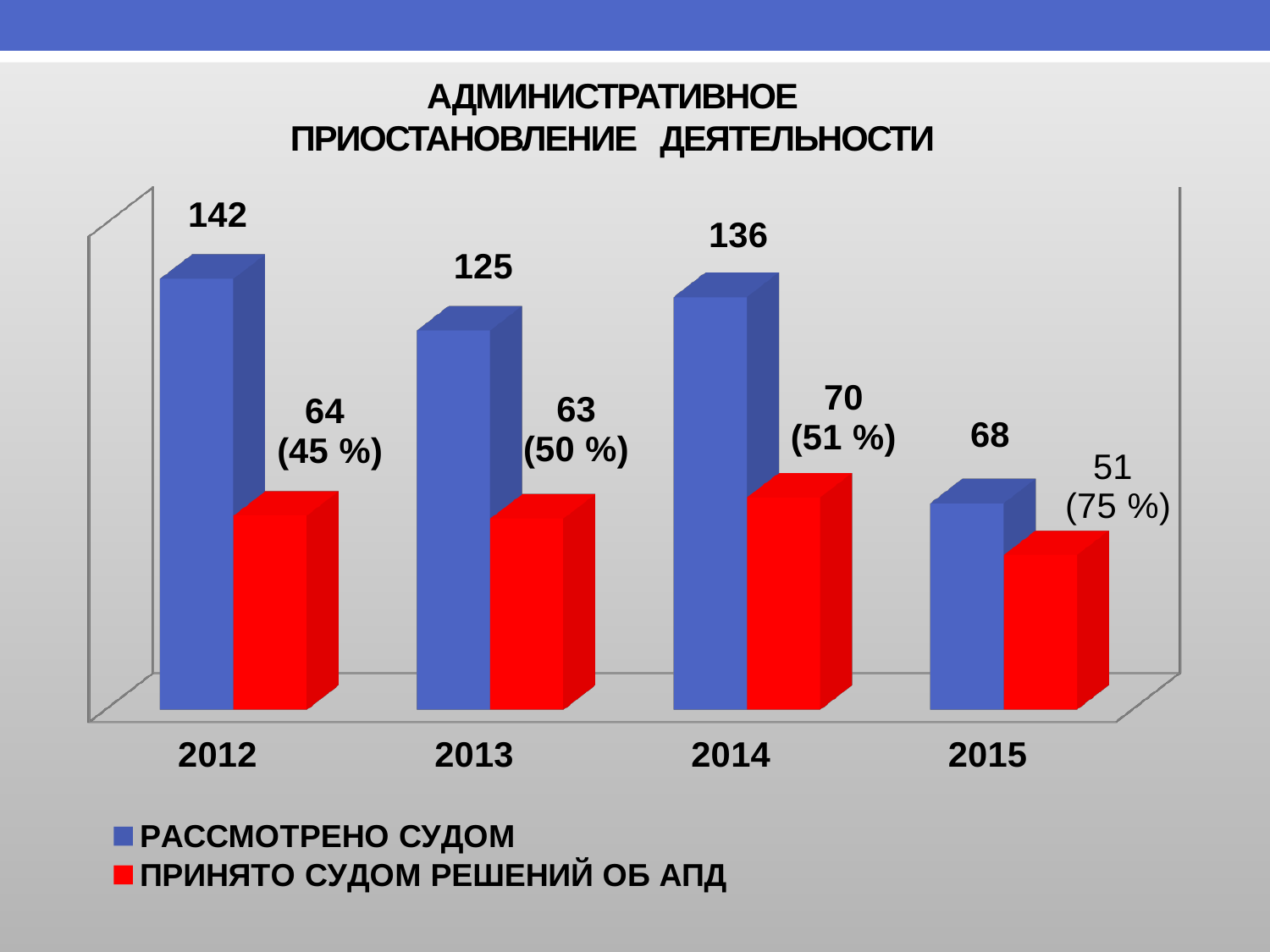
Which is larger: РАССМОТРЕНО СУДОМ in 2014 or РАССМОТРЕНО СУДОМ in 2013? 2014 In which year is the value for ПРИНЯТО СУДОМ РЕШЕНИЙ ОБ АПД lowest? 2015 What is the difference between РАССМОТРЕНО СУДОМ and ПРИНЯТО СУДОМ РЕШЕНИЙ ОБ АПД in 2013? 62 What kind of chart is shown on the slide? bar chart What is the value for РАССМОТРЕНО СУДОМ in 2015? 68 Which colour represents ПРИНЯТО СУДОМ РЕШЕНИЙ ОБ АПД in the legend? red How many years are shown on the x axis? 4 How many series does the legend list? 2 In which year is the value for РАССМОТРЕНО СУДОМ highest? 2012 What is the value for РАССМОТРЕНО СУДОМ in 2012? 142 What is the value for ПРИНЯТО СУДОМ РЕШЕНИЙ ОБ АПД in 2014? 70 What percentage is shown next to the ПРИНЯТО СУДОМ РЕШЕНИЙ ОБ АПД value for 2015? 75 %